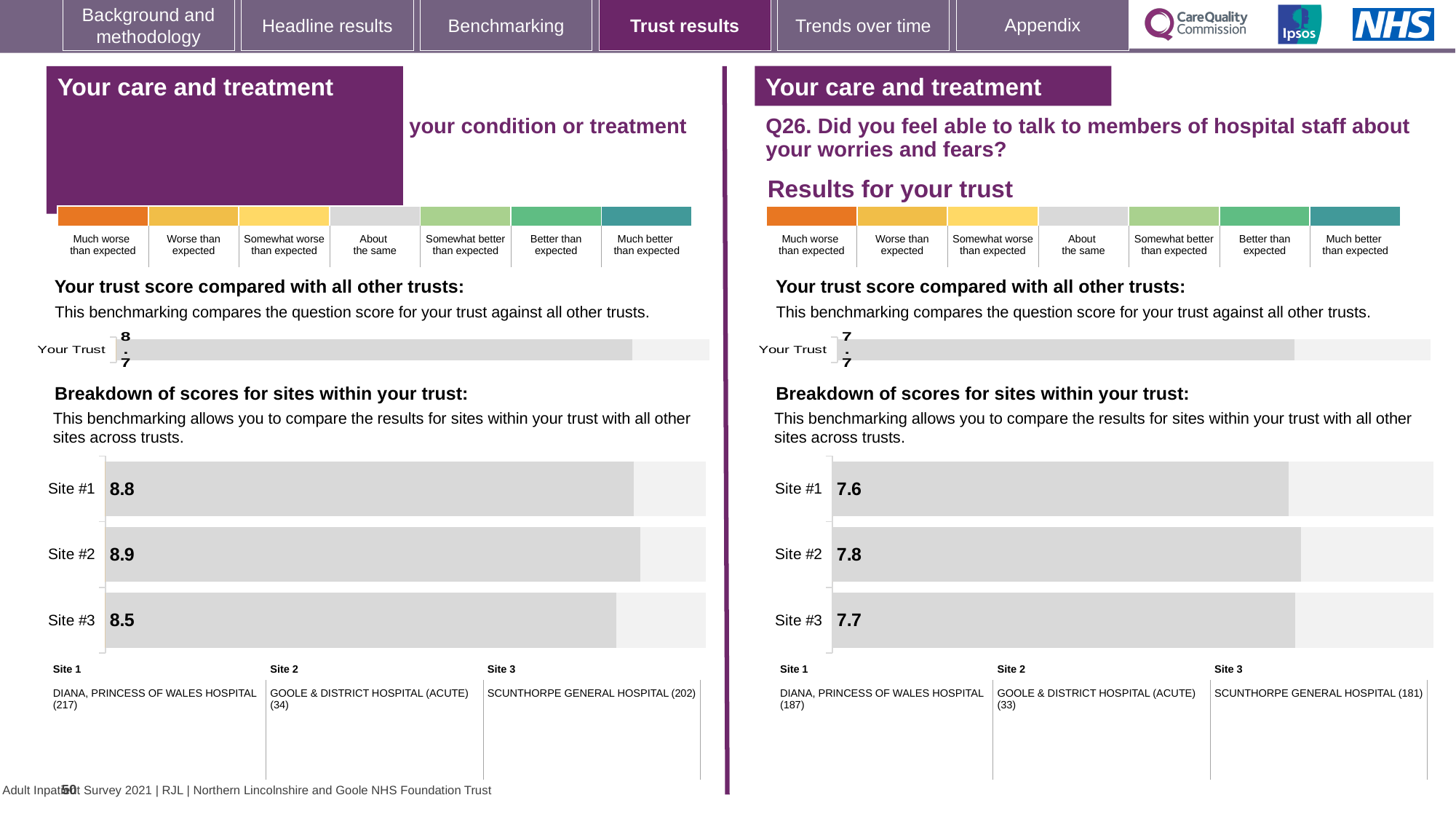
In the Q26 site breakdown chart on the right, how many sites are shown? 3 In the Q26 site breakdown chart on the right, what is the score for Site #2? 7.8 In the Q26 site breakdown chart on the right, what is the score for Site #1? 7.6 Is the Site #1 score in the left-hand site breakdown chart larger or smaller than the Site #1 score in the Q26 chart on the right? Larger In the left-hand site breakdown chart, what is the difference between the scores for Site #2 and Site #3? 0.4 What type of chart is used for the site breakdown on the left-hand side of the slide? Bar chart In the Q26 site breakdown chart on the right, what is the difference between the scores for Site #2 and Site #1? 0.2 In the left-hand site breakdown chart, what is the score for Site #1? 8.8 In the left-hand site breakdown chart, what is the score for Site #3? 8.5 In the left-hand site breakdown chart, which site has the highest score? Site #2 In the left-hand site breakdown chart, which site has the lowest score? Site #3 In the Q26 site breakdown chart on the right, which site has the lowest score? Site #1